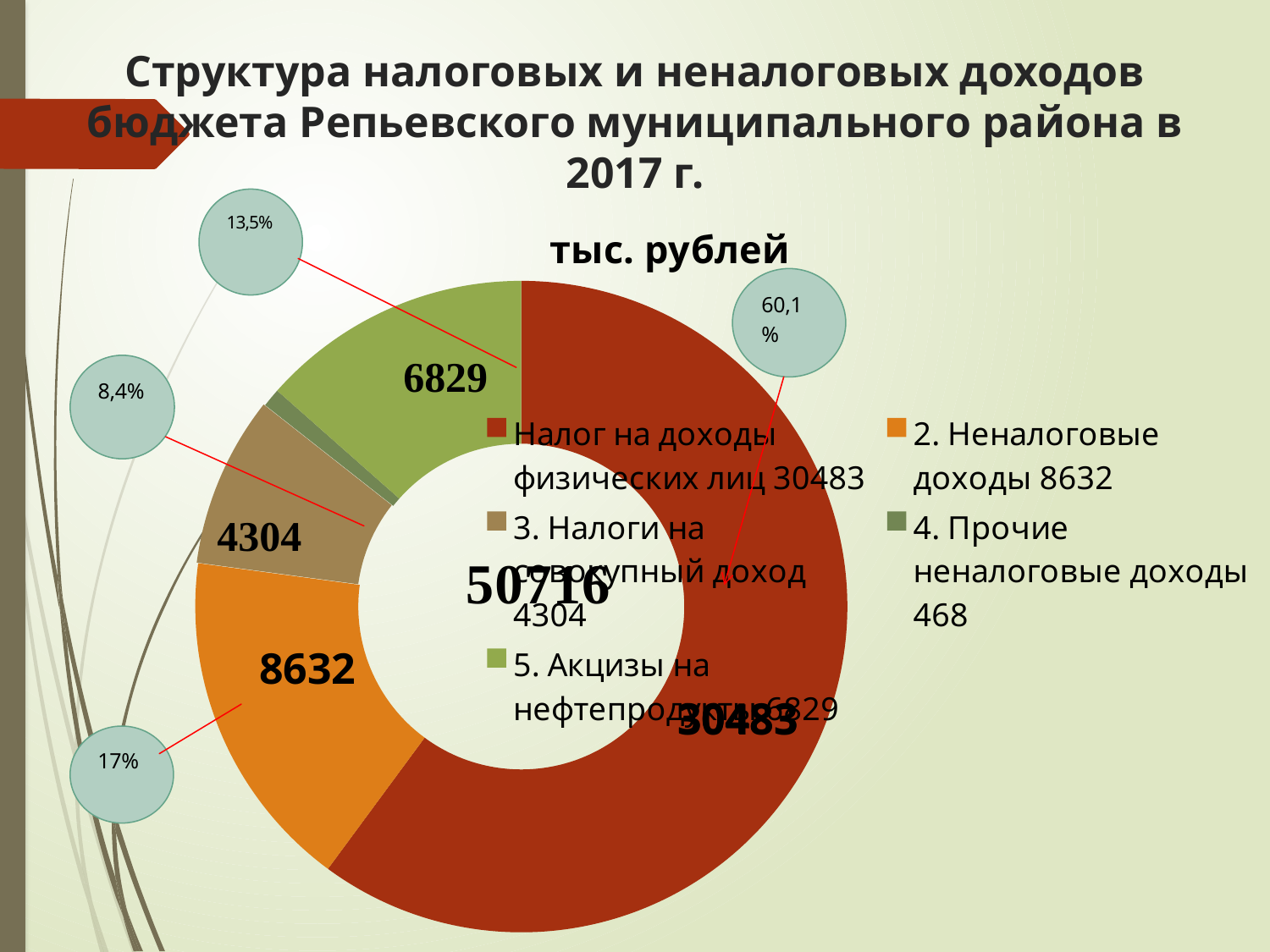
What is the value for "2. Неналоговые доходы"? 8632 What is the difference between the values for "2. Неналоговые доходы" and "3. Налоги на совокупный доход"? 4328 Which category has the largest value? Налог на доходы физических лиц What kind of chart is shown on the slide? doughnut chart What is the value for "3. Налоги на совокупный доход"? 4304 Which category has the smallest value? 4. Прочие неналоговые доходы What is the value for "Налог на доходы физических лиц"? 30483 What is the value for "4. Прочие неналоговые доходы"? 468 What total is printed in the centre of the doughnut chart? 50716 What is the value for "5. Акцизы на нефтепродукты"? 6829 Which is larger: the value for "5. Акцизы на нефтепродукты" or the value for "2. Неналоговые доходы"? 2. Неналоговые доходы How many categories does the legend list? 5